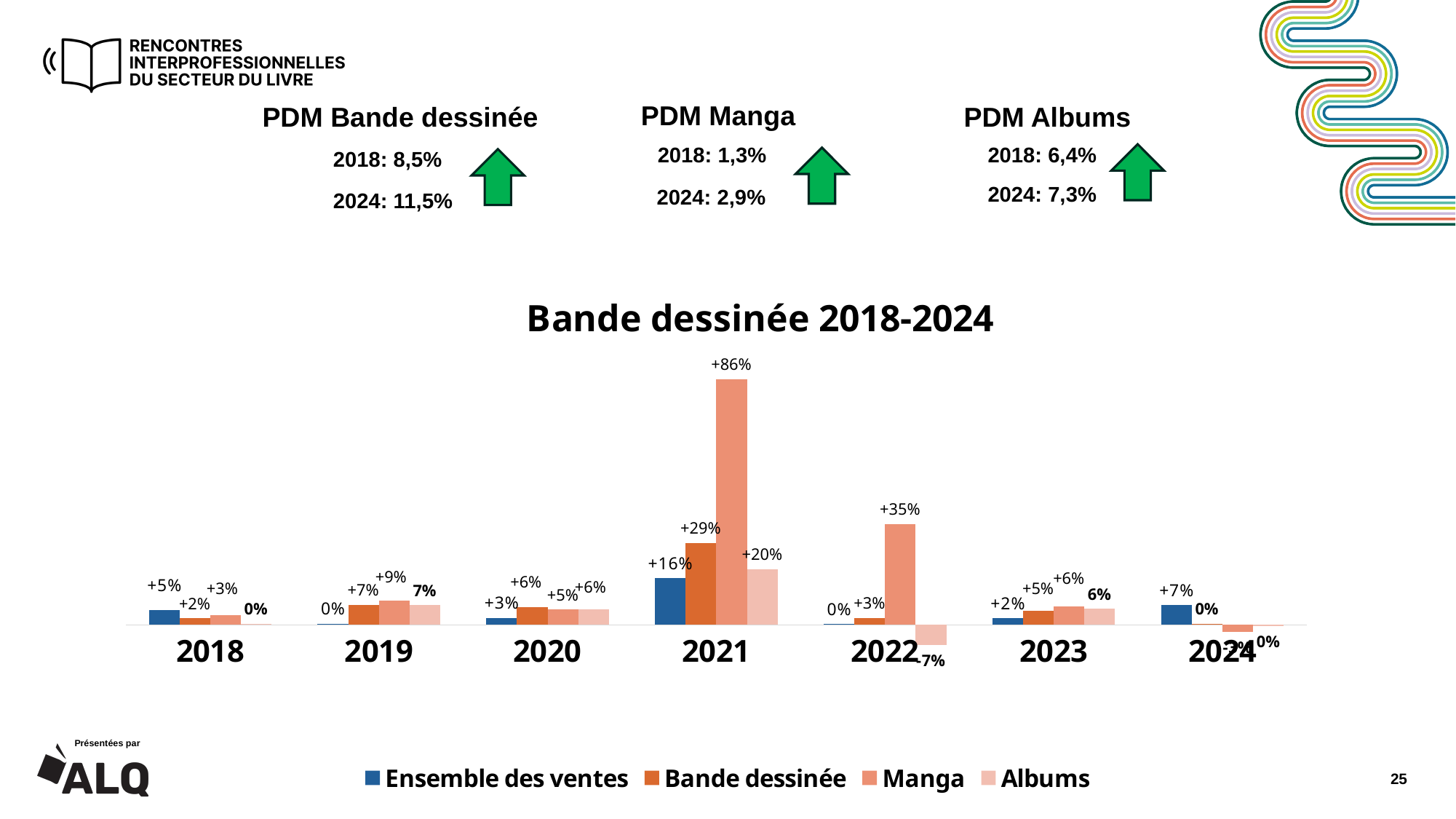
What is the value for Manga in 2021? +86% How many series does the legend of the chart list? 4 In which year is the Manga value highest? 2021 In which year is the Albums value lowest? 2022 What is the value for Bande dessinée in 2021? +29% How many years are shown on the x axis of the chart? 7 In 2022, which is larger: the Manga value or the Bande dessinée value? Manga What is the title of the chart? Bande dessinée 2018-2024 What is the difference between the Manga value and the Bande dessinée value in 2021? 57 percentage points What is the value for Albums in 2022? -7% What is the value for Ensemble des ventes in 2024? +7% What type of chart is shown on the slide? bar chart